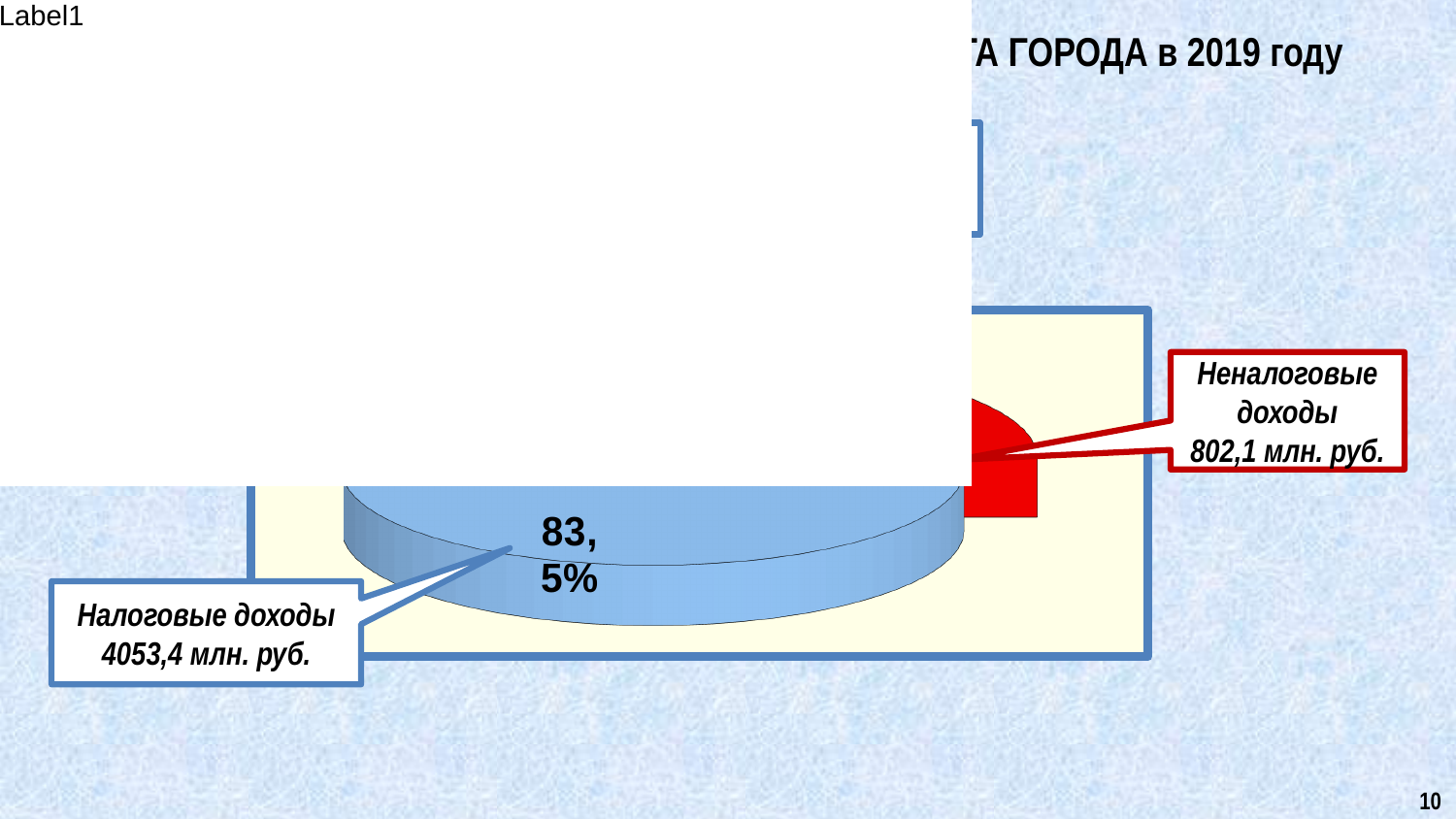
Which category has the largest slice of the pie? Налоговые доходы What is the value shown for Налоговые доходы? 4053,4 млн. руб. What kind of chart is shown on the slide? pie chart Which category has the smallest slice of the pie? Неналоговые доходы What is the value shown for Неналоговые доходы? 802,1 млн. руб. What is the difference between Налоговые доходы and Неналоговые доходы in млн. руб.? 3251,3 млн. руб. What colour is the slice for Неналоговые доходы? red What colour is the slice for Налоговые доходы? blue Which is larger, Налоговые доходы or Неналоговые доходы? Налоговые доходы Is the share of Налоговые доходы greater or less than 50%? greater What share of the pie does the blue slice (Налоговые доходы) represent? 83,5%